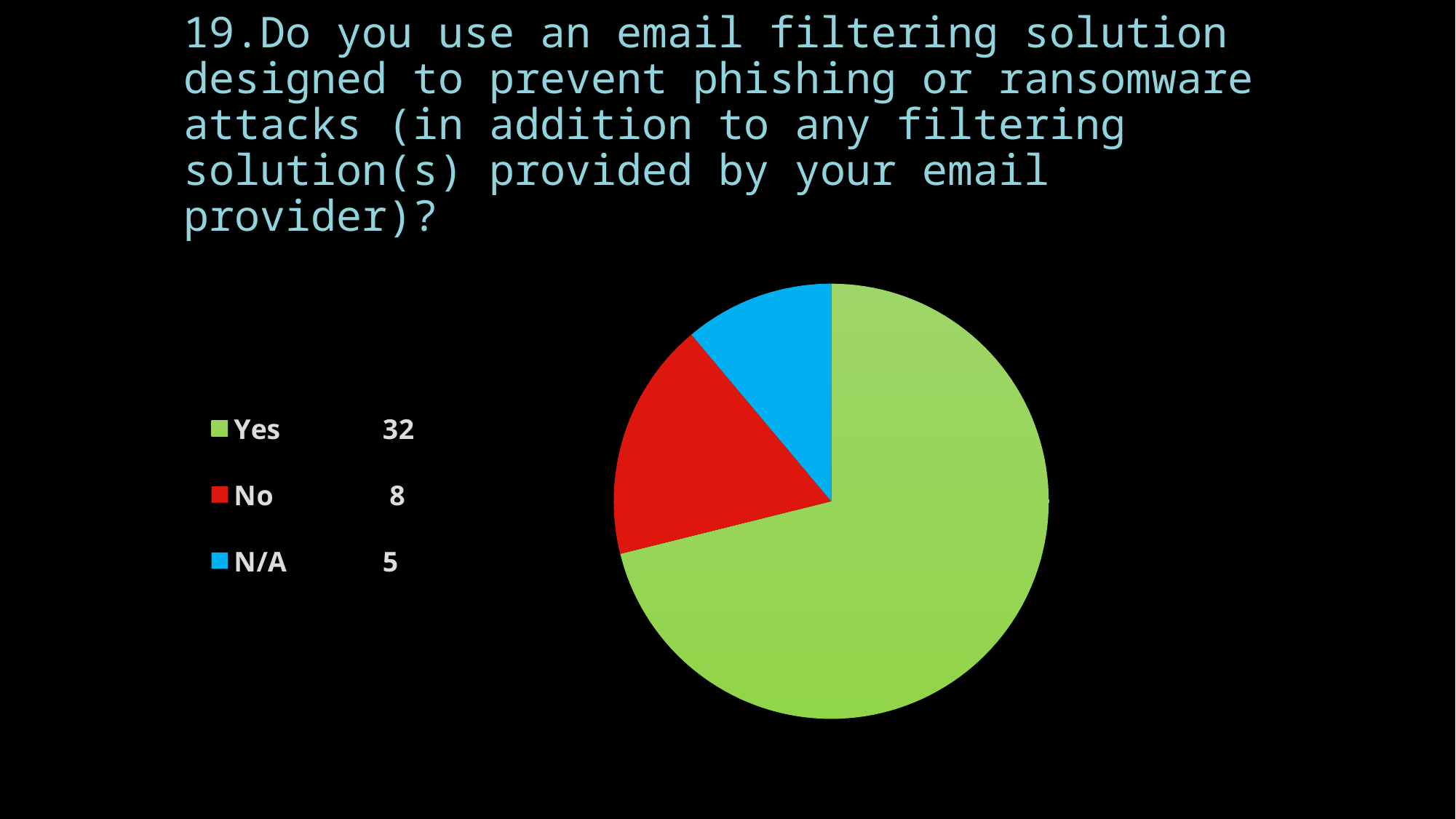
Which is larger, the count for No or the count for N/A? No Which category has the smallest slice of the pie? N/A How many responses are recorded for Yes? 32 What kind of chart is shown on the slide? pie chart What is the difference between the No and N/A counts? 3 How many categories does the pie chart have? 3 How many responses are recorded for No? 8 How many responses are recorded for N/A? 5 What colour is the slice for No? red What is the total number of responses across all slices? 45 What is the difference between the Yes and No counts? 24 Which category has the largest slice of the pie? Yes